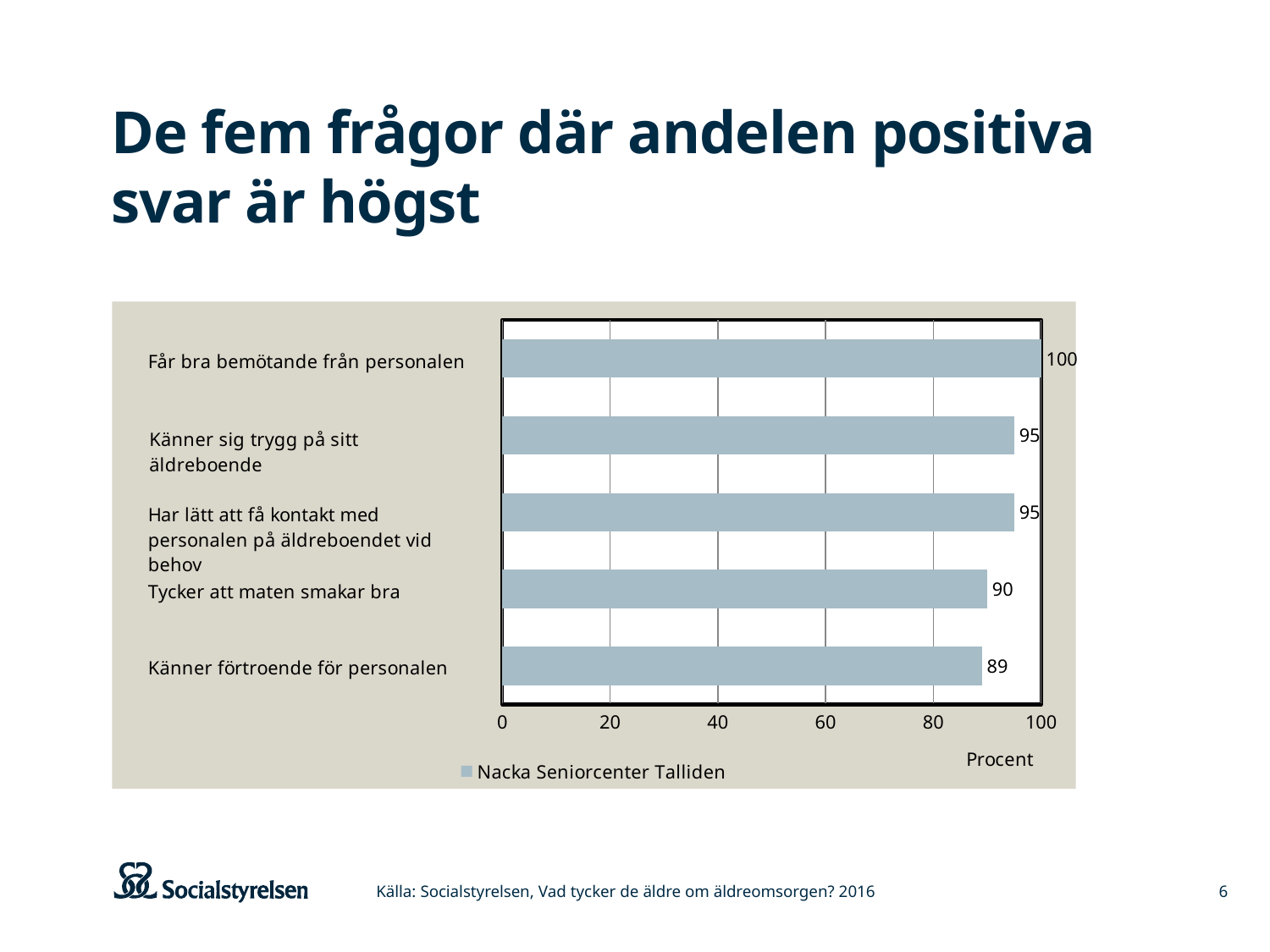
What is the value for "Tycker att maten smakar bra"? 90 What is the difference between the values for "Får bra bemötande från personalen" and "Känner förtroende för personalen"? 11 Which category has the highest value? Får bra bemötande från personalen Which category has the lowest value? Känner förtroende för personalen What is the value for "Känner sig trygg på sitt äldreboende"? 95 What is the value for "Får bra bemötande från personalen"? 100 Which is larger, the value for "Tycker att maten smakar bra" or the value for "Har lätt att få kontakt med personalen på äldreboendet vid behov"? Har lätt att få kontakt med personalen på äldreboendet vid behov How many categories are shown in the chart? 5 How many series does the legend list? 1 What kind of chart is shown on the slide? Bar chart What is the name of the series shown in the legend? Nacka Seniorcenter Talliden What is the value for "Känner förtroende för personalen"? 89